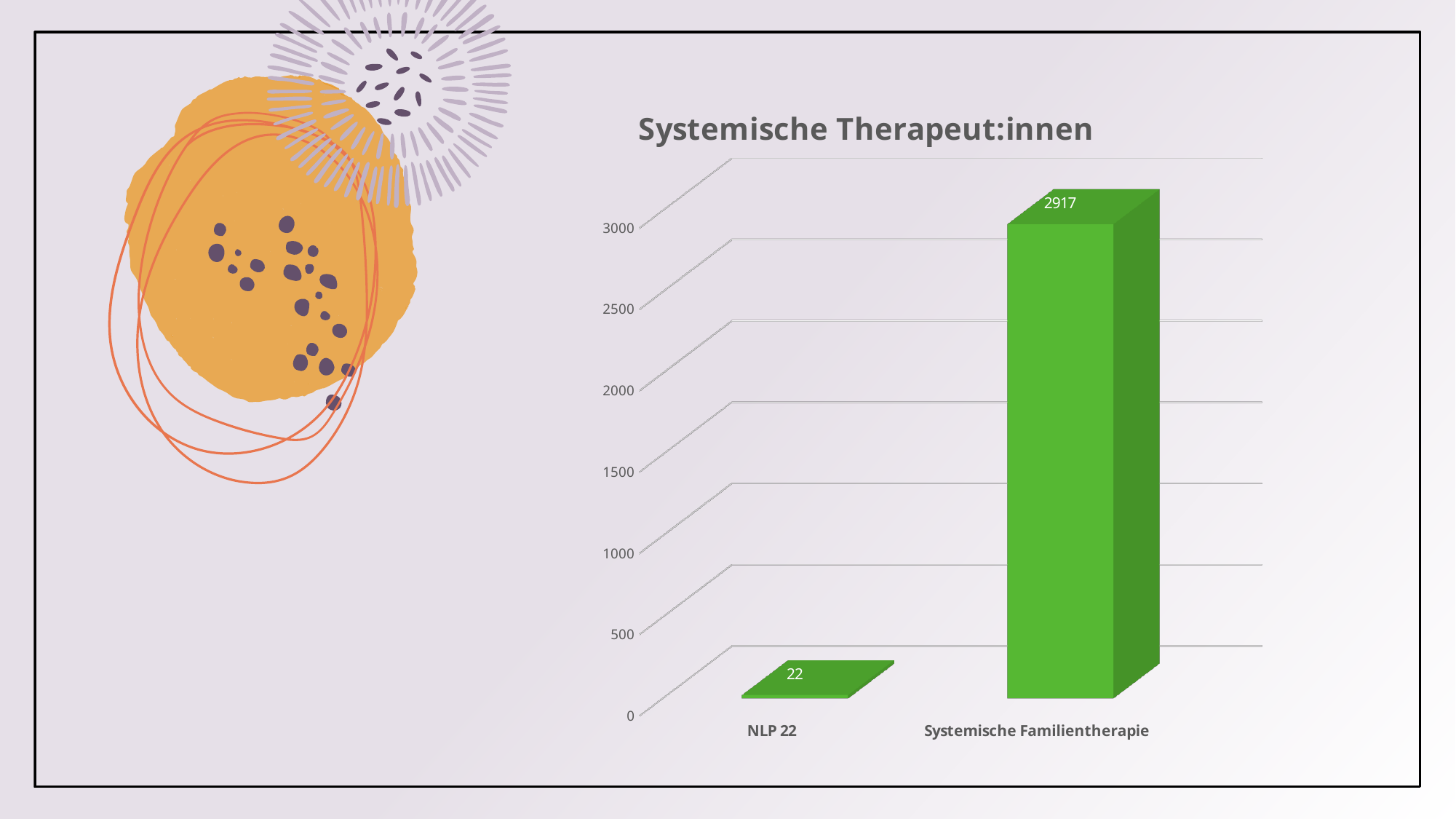
Which is larger, the value for NLP 22 or the value for Systemische Familientherapie? Systemische Familientherapie What is the difference between the values for Systemische Familientherapie and NLP 22? 2895 What is the value for NLP 22? 22 What colour are the bars in the chart? green Which category has the lowest value? NLP 22 How many categories are shown in the chart? 2 Is the value for NLP 22 greater or less than 500? less What is the value for Systemische Familientherapie? 2917 What is the title of the chart? Systemische Therapeut:innen Is the value for Systemische Familientherapie greater or less than 2500? greater Which category has the highest value? Systemische Familientherapie What kind of chart is shown on the slide? bar chart